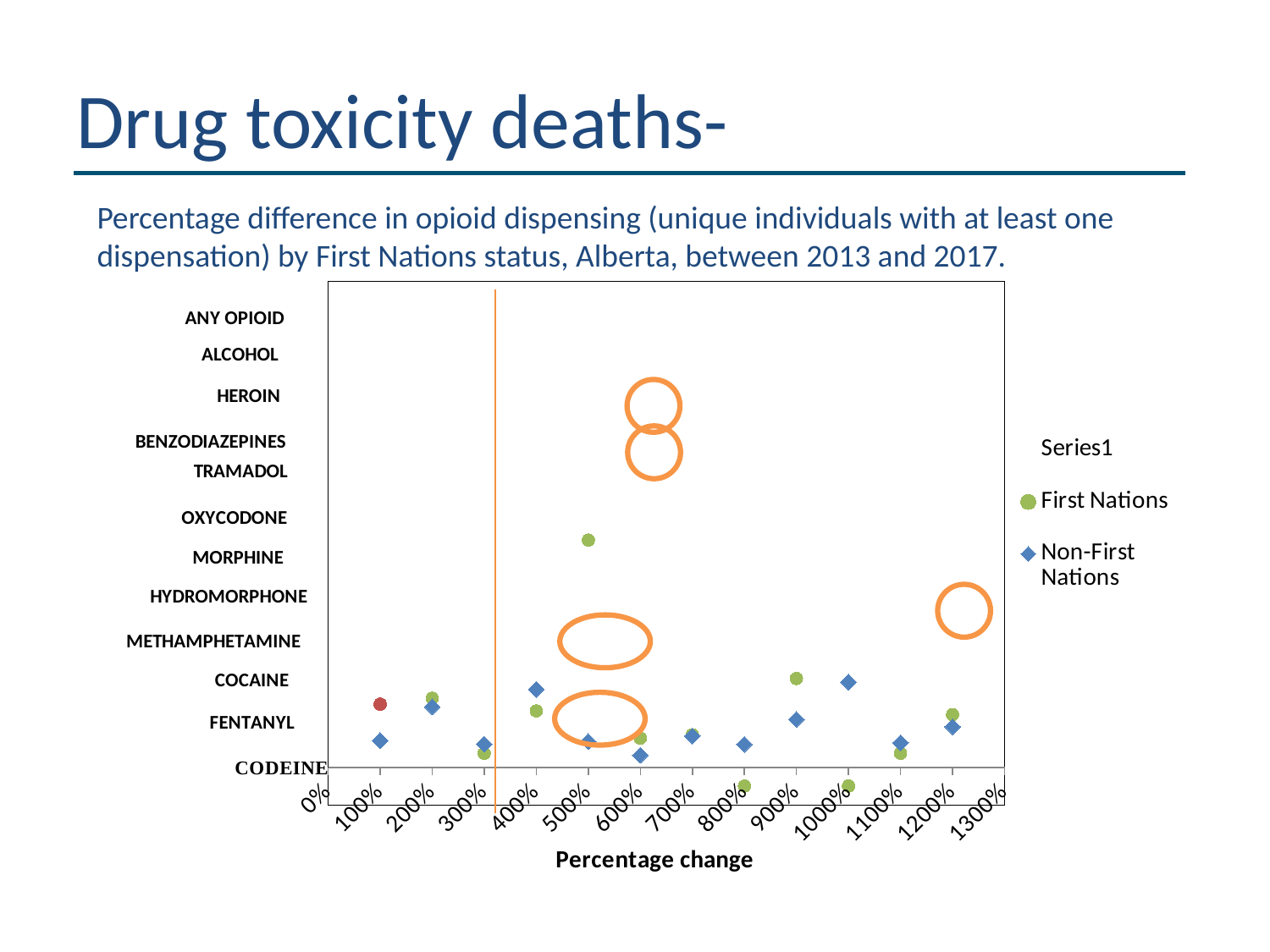
Is the leftmost Non-First Nations point greater or less than 200%? less Is the rightmost First Nations point greater or less than 1100%? greater What kind of chart is shown on the slide? scatter chart How many drug categories are labelled on the vertical axis? 12 How many series does the legend list? 3 What is the title of the horizontal axis? Percentage change What is the highest tick value shown on the horizontal axis? 1300%